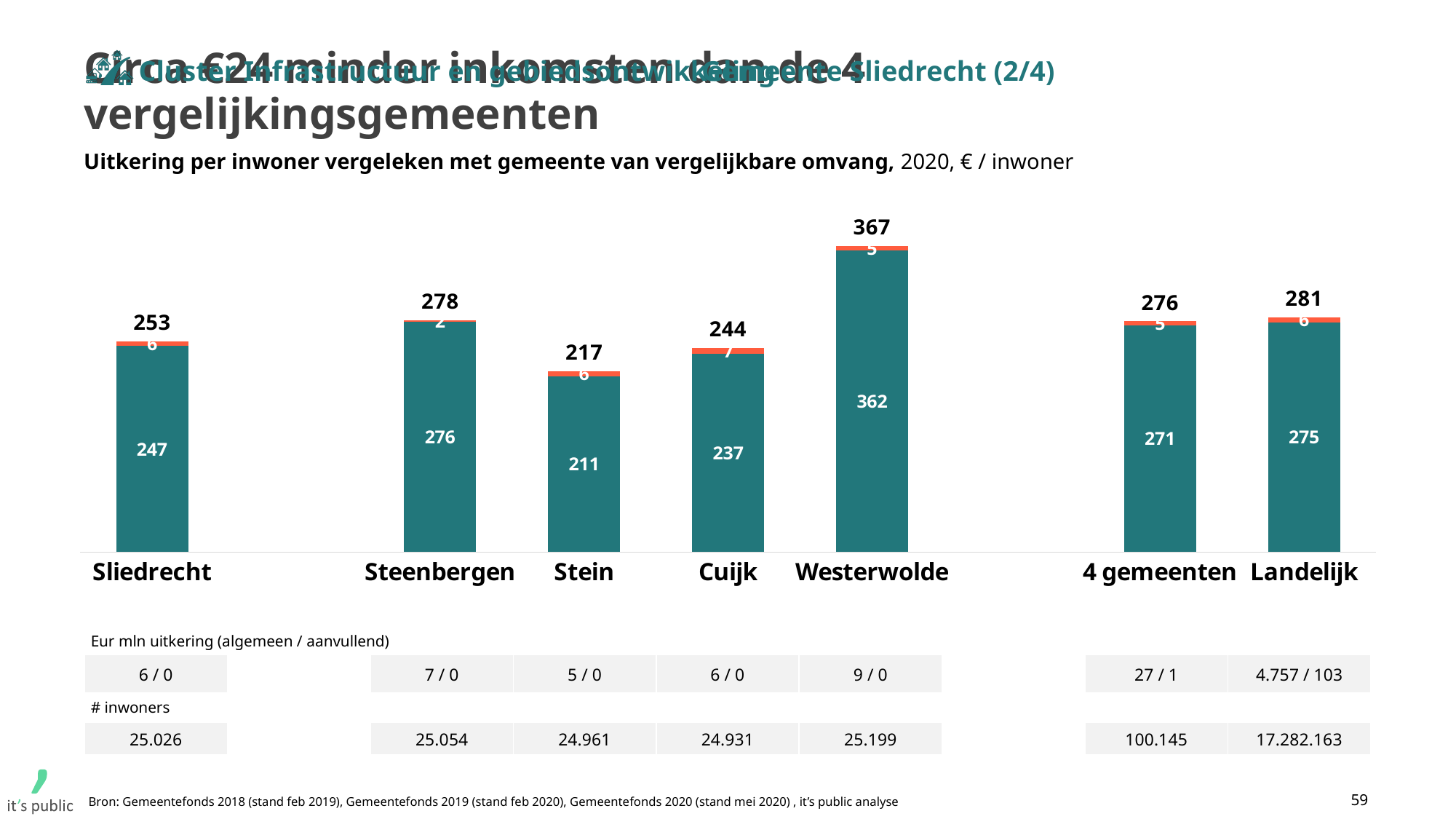
What is the difference between the total for Westerwolde and the total for Cuijk? 123 What kind of chart is shown on the slide? Stacked bar chart How many categories are shown on the x axis of the chart? 7 Which category has the highest total bar? Westerwolde What is the total value shown above the bar for Westerwolde? 367 Which category has the lowest total bar? Stein What is the value of the large teal segment of the Sliedrecht bar? 247 What is the difference between the total for Landelijk and the total for Sliedrecht? 28 What is the total of the stacked bar for 4 gemeenten? 276 Which has a larger total bar, Steenbergen or Cuijk? Steenbergen What is the total value shown above the bar for Stein? 217 What is the value of the teal segment of the Landelijk bar? 275